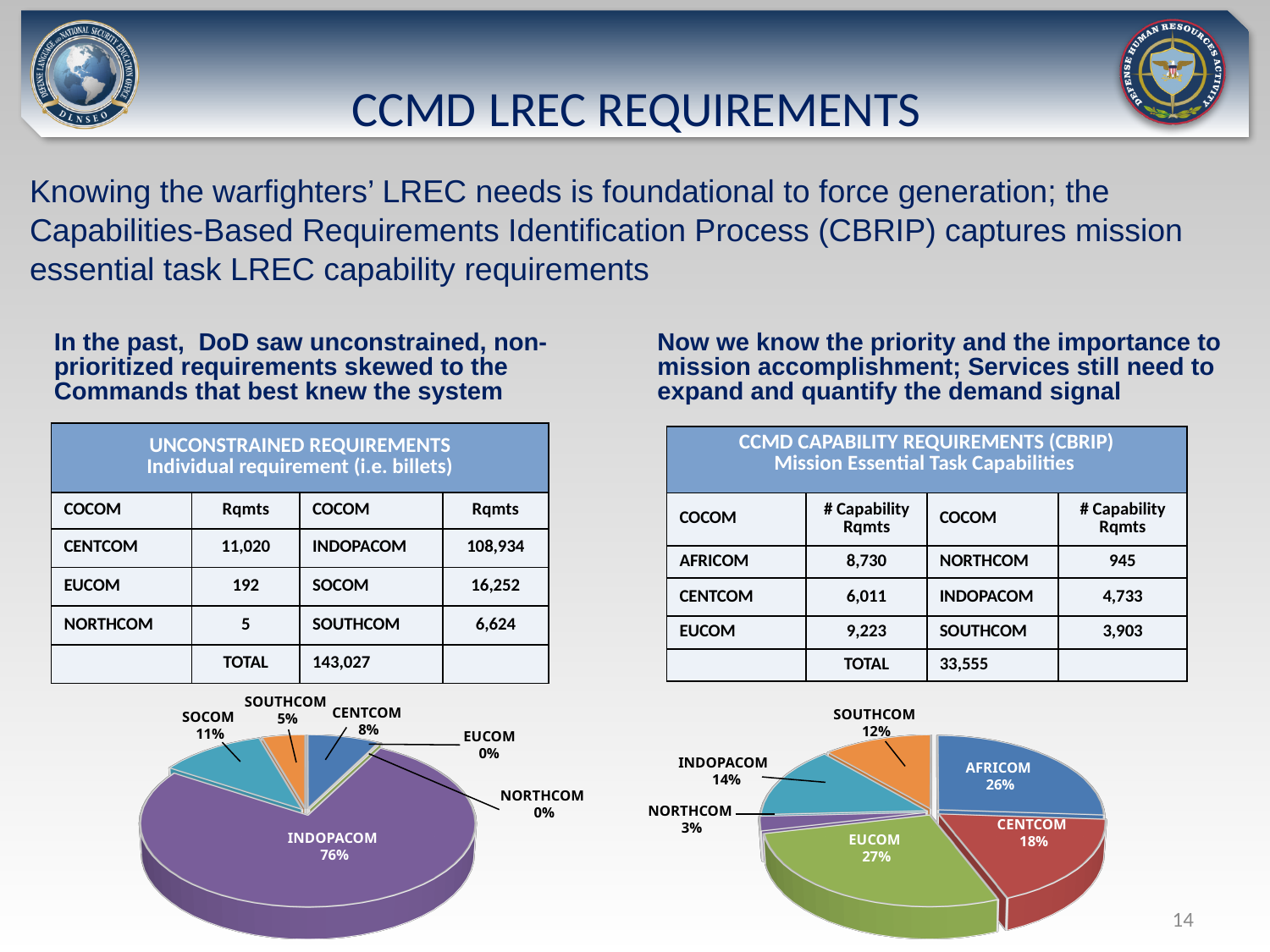
In the left pie chart, which command has the largest slice? INDOPACOM What kind of chart is the left-hand chart at the bottom of the slide? pie chart In the left pie chart, what percentage share does INDOPACOM have? 76% In the left pie chart, what is the difference in percentage points between the SOCOM and SOUTHCOM slices? 6 In the right pie chart, which slice is larger, AFRICOM or CENTCOM? AFRICOM In the right pie chart, what percentage share does NORTHCOM have? 3% In the right pie chart, which command has the smallest slice? NORTHCOM In the right pie chart, what is the difference in percentage points between the INDOPACOM and SOUTHCOM slices? 2 In the right pie chart, what percentage share does EUCOM have? 27% In the right pie chart, how many commands are shown as slices? 6 In the left pie chart, how many slices (commands) are labelled? 6